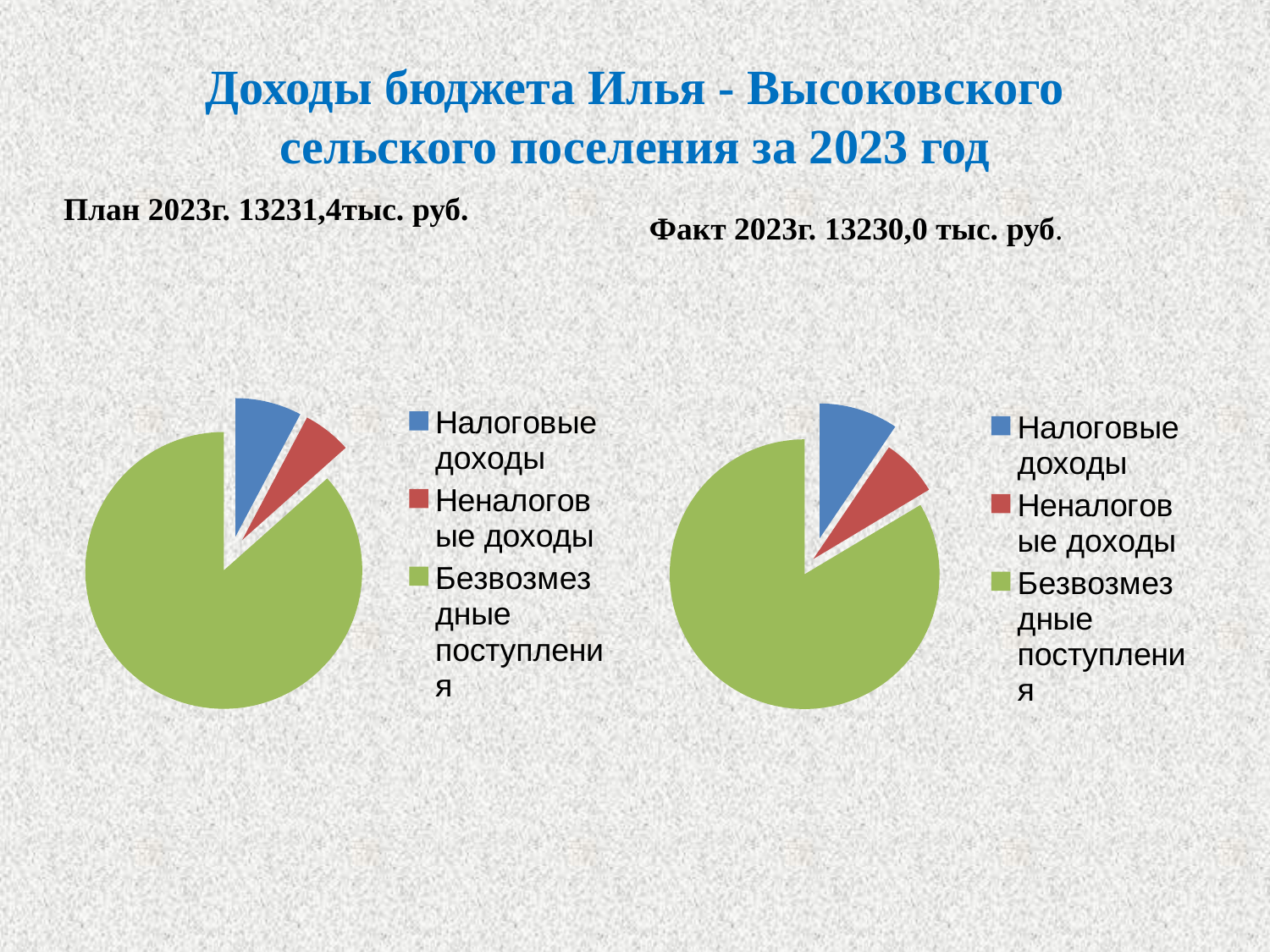
In the right chart (Факт 2023г.), which slice is larger: Налоговые доходы or Неналоговые доходы? Налоговые доходы What kind of chart is the right chart titled "Факт 2023г. 13230,0 тыс. руб."? pie chart What kind of chart is the left chart titled "План 2023г. 13231,4тыс. руб."? pie chart In the right chart (Факт 2023г.), which category has the smallest slice? Неналоговые доходы In the left chart (План 2023г.), which slice is larger: Налоговые доходы or Безвозмездные поступления? Безвозмездные поступления In the right chart (Факт 2023г.), how many categories does the legend list? 3 In the left chart (План 2023г.), which category has the smallest slice? Неналоговые доходы In the left chart (План 2023г.), how many slices does the pie have? 3 In the right chart (Факт 2023г.), which category has the largest slice? Безвозмездные поступления What colour represents Безвозмездные поступления in both pie charts? green What is the title of the right chart? Факт 2023г. 13230,0 тыс. руб. In the left chart (План 2023г.), which category has the largest slice? Безвозмездные поступления